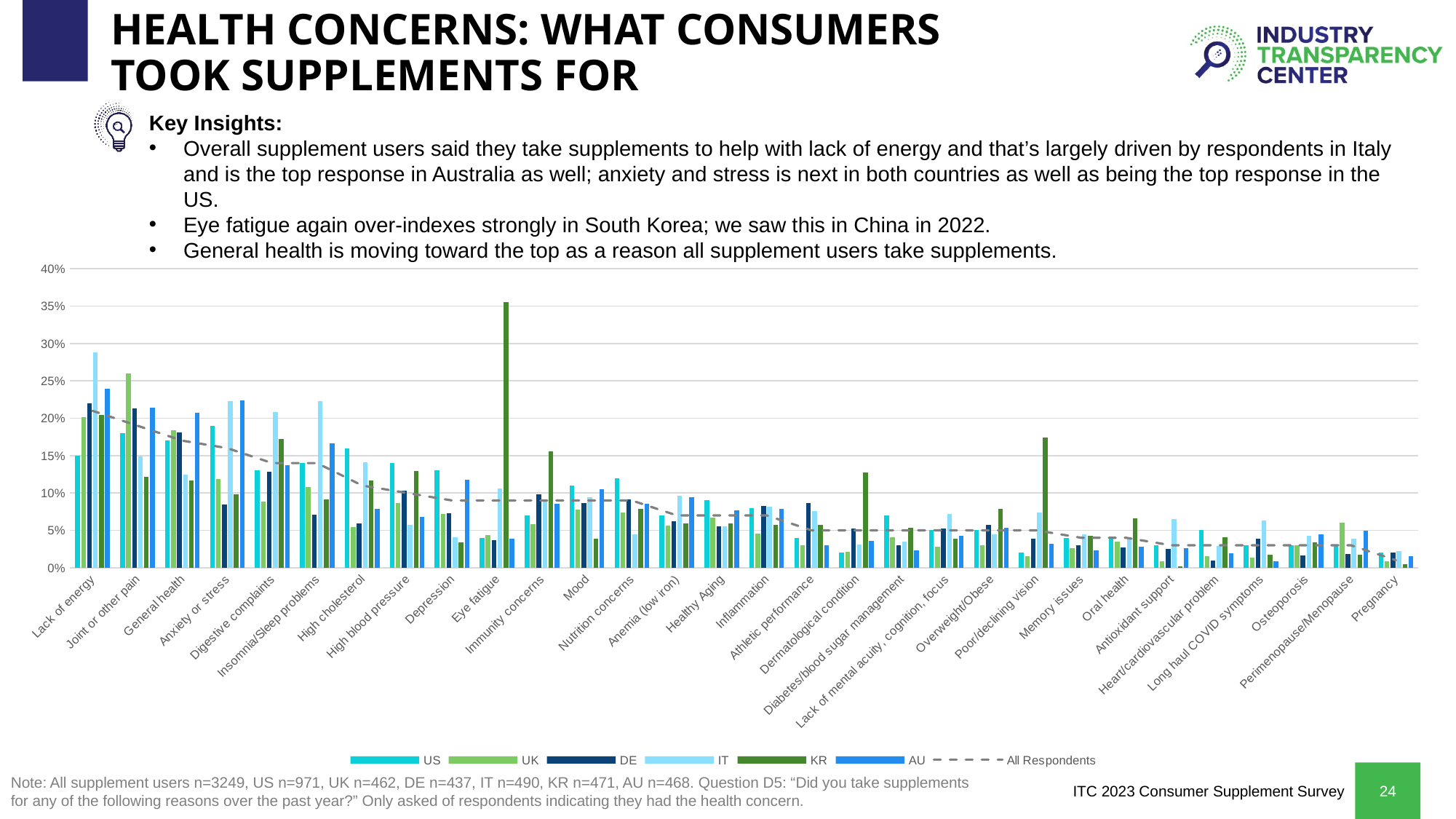
Is the US value for Pregnancy greater or less than 5%? less Which series has the tallest bar for Eye fatigue? KR How many series does the legend list? 7 Is the IT value for Lack of energy greater or less than 25%? greater For Eye fatigue, which is larger: the KR value or the US value? KR Is the KR value for Eye fatigue greater or less than 30%? greater What kind of chart is shown on the slide? Bar chart (with a dashed line for All Respondents) How many health concern categories are shown on the x axis? 30 Does the All Respondents dashed line generally rise or fall from left to right across the categories? Fall Which series is shown as a dashed line rather than bars? All Respondents Which series has the tallest bar for Lack of energy? IT